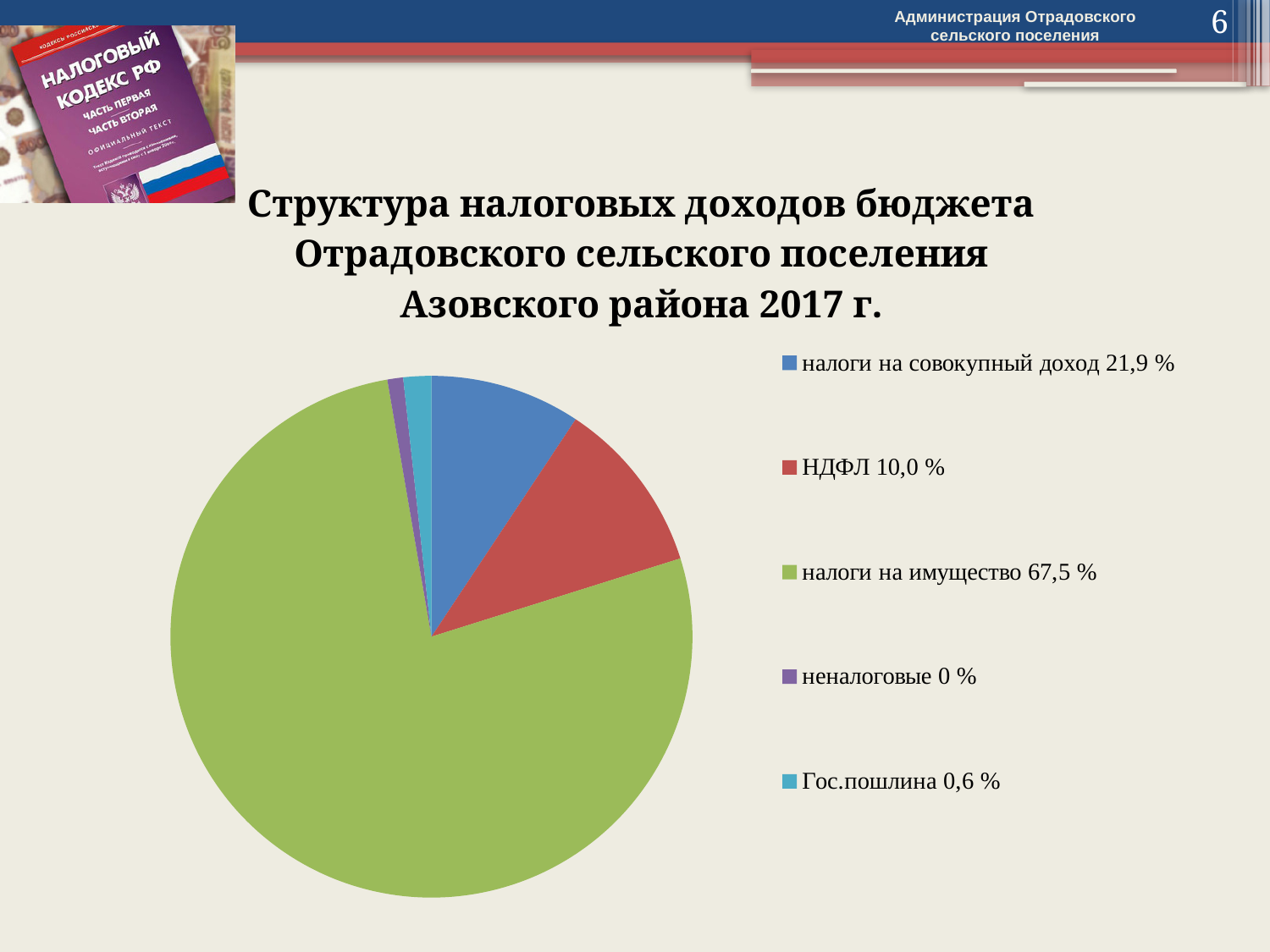
What share is shown for НДФЛ? 10,0 % What share is shown for Гос.пошлина? 0,6 % What is the difference between the shares for налоги на совокупный доход and НДФЛ? 11,9 % Which is larger: the share for налоги на совокупный доход or the share for НДФЛ? налоги на совокупный доход What share is shown for налоги на совокупный доход? 21,9 % Which category has the largest share of the pie? налоги на имущество How many categories does the legend list? 5 What share of tax revenues is attributed to налоги на имущество? 67,5 % What is the difference between the shares for налоги на имущество and налоги на совокупный доход? 45,6 % What colour is the slice for налоги на имущество? green What kind of chart is shown on the slide? pie chart Which year does the chart title refer to? 2017